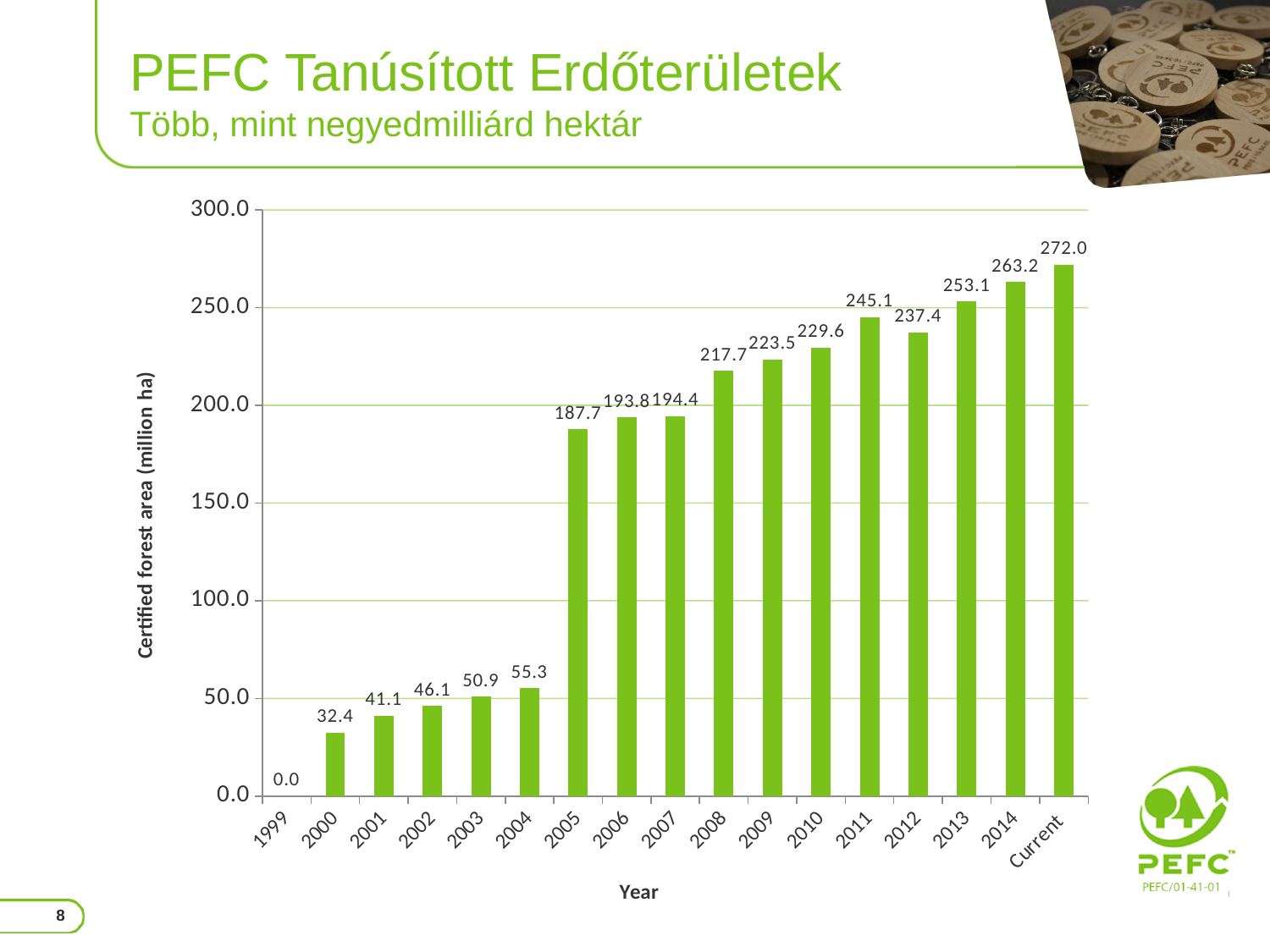
What is the certified forest area for 2000? 32.4 Do the values generally rise or fall from 1999 to Current? rise Which is larger, the certified forest area for 2011 or 2012? 2011 What kind of chart is shown on the slide? bar chart How many categories are shown on the x axis? 17 Is the value for 2008 greater or less than 200.0? greater Which category has the highest certified forest area? Current What is the certified forest area for 2011? 245.1 Which year has the lowest certified forest area? 1999 What is the label of the y axis? Certified forest area (million ha) What is the certified forest area for 2005? 187.7 What is the difference between the certified forest area for 2014 and 2013? 10.1